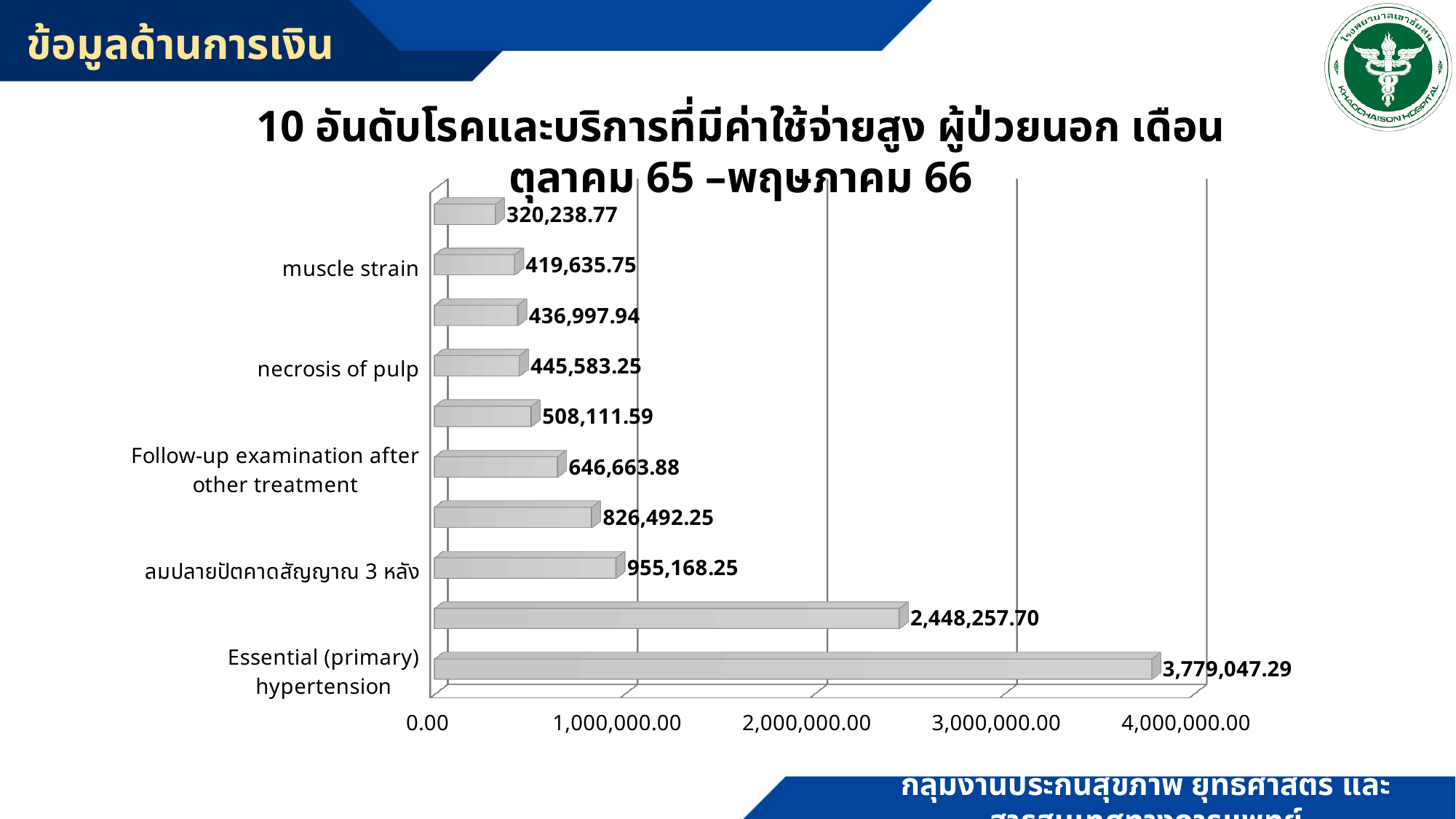
What is the value for Follow-up examination after other treatment? 646,663.88 What is the value for muscle strain? 419,635.75 What is the difference between the value for Essential (primary) hypertension and the value for ลมปลายปัตคาดสัญญาณ 3 หลัง? 2,823,879.04 What type of chart is shown on the slide? bar chart Which is larger, the value for necrosis of pulp or the value for muscle strain? necrosis of pulp Which labelled category has the highest value? Essential (primary) hypertension What is the largest value shown on the x axis? 4,000,000.00 Is the value for Follow-up examination after other treatment greater or less than 1,000,000.00? less What is the value for Essential (primary) hypertension? 3,779,047.29 What is the value for necrosis of pulp? 445,583.25 How many bars are plotted in the chart? 10 What is the value for ลมปลายปัตคาดสัญญาณ 3 หลัง? 955,168.25